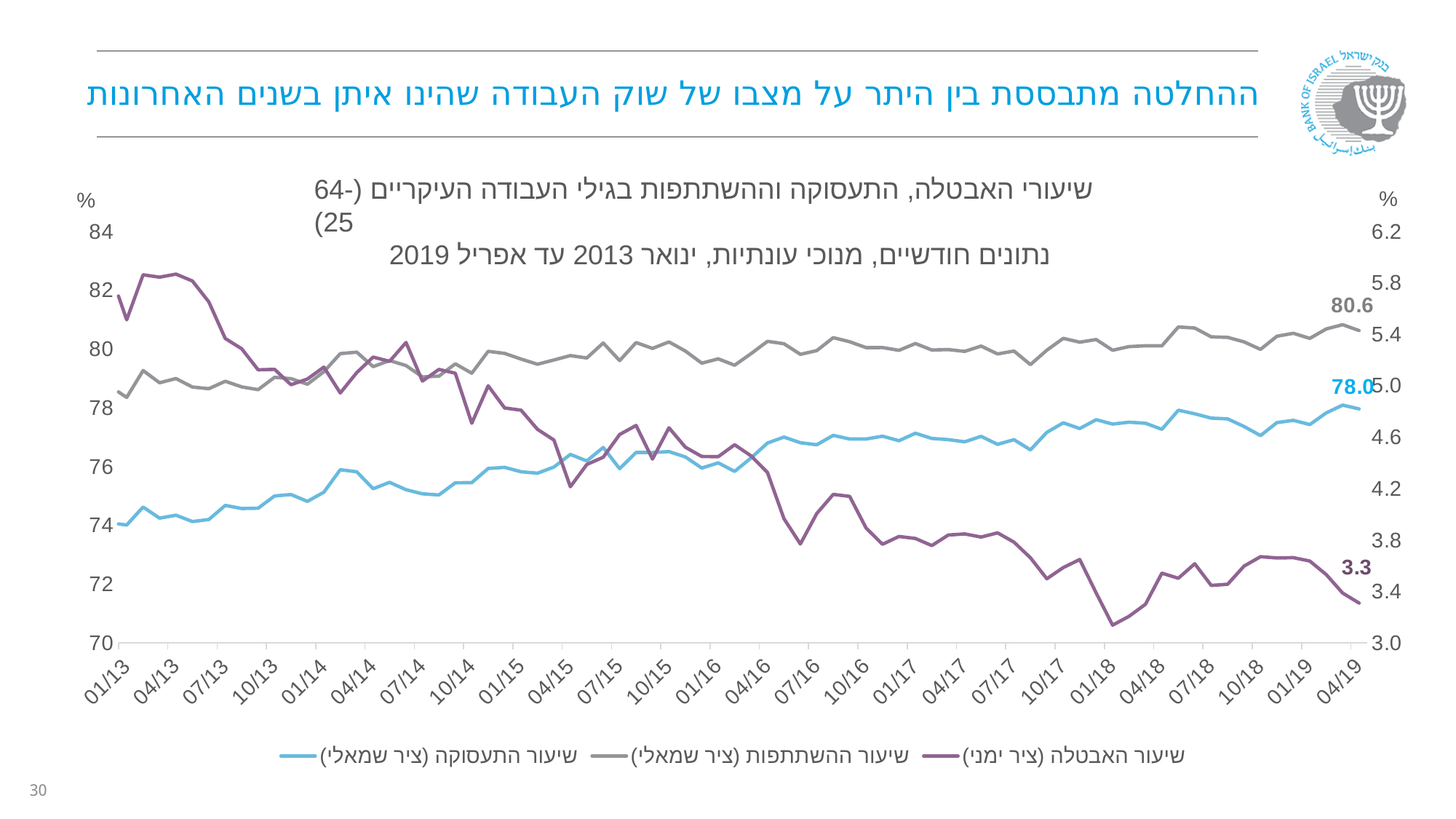
What is the labelled value of the employment rate (שיעור התעסוקה) at the end of the series, in 04/19? 78.0 According to the legend, on which axis is the unemployment rate (שיעור האבטלה) plotted? the right axis (ציר ימני) What kind of chart is shown on the slide? line chart What is the labelled value of the unemployment rate (שיעור האבטלה) at the end of the series, in 04/19? 3.3 Does the employment rate (שיעור התעסוקה) generally rise or fall from 01/13 to 04/19? rise At 04/19, which is higher: the participation rate or the employment rate? the participation rate Is the unemployment rate (שיעור האבטלה) in 01/13 greater or less than 5.4 on the right axis? greater What is the difference between the labelled participation rate (80.6) and the labelled employment rate (78.0) at the end of the series? 2.6 Does the unemployment rate (שיעור האבטלה) generally rise or fall from 01/13 to 04/19? fall How many series does the legend list? 3 Is the employment rate (שיעור התעסוקה) in 01/13 greater or less than 76 on the left axis? less What is the labelled value of the participation rate (שיעור ההשתתפות) at the end of the series, in 04/19? 80.6